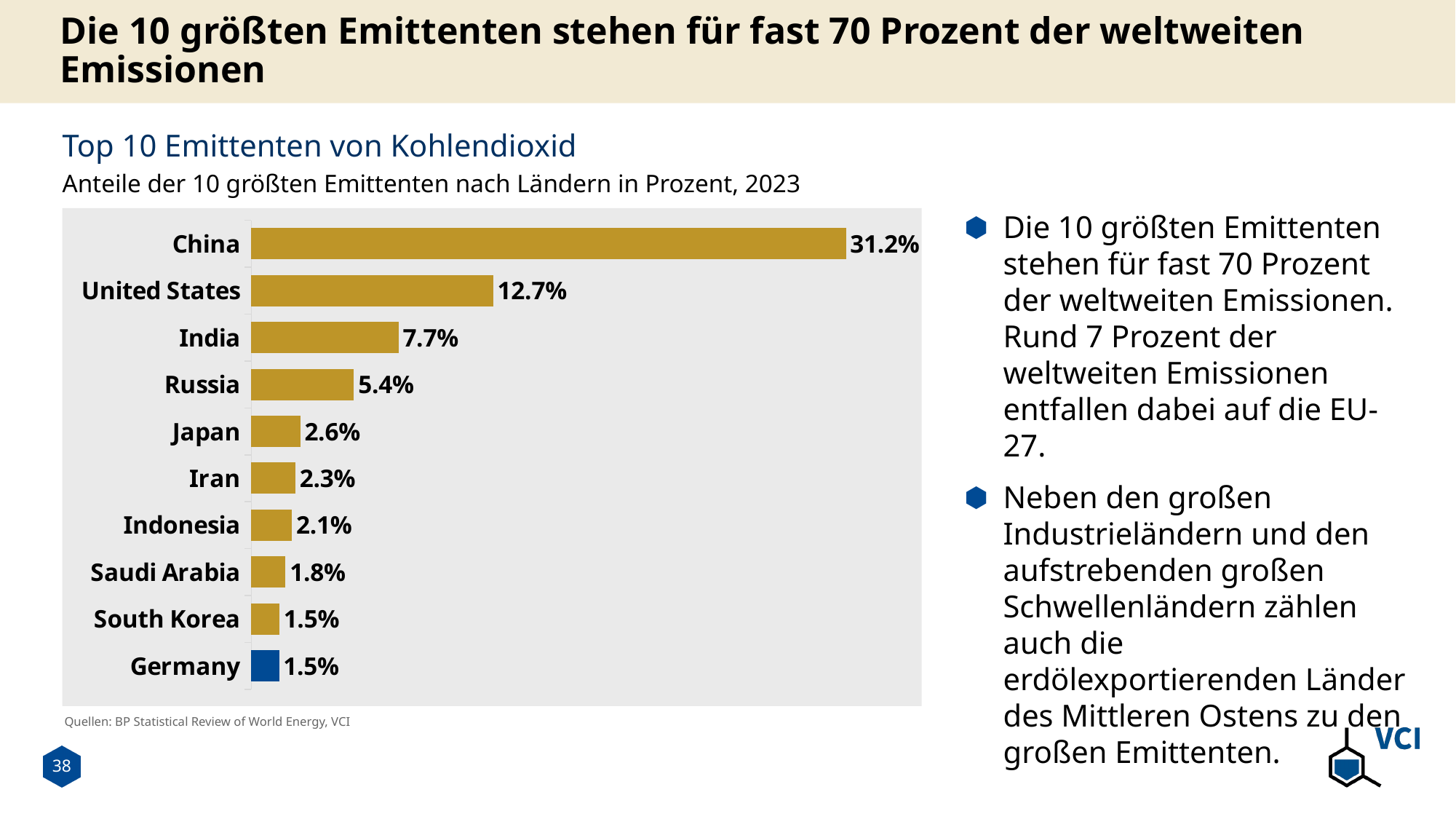
What is the value for China? 31.2% Do the values rise or fall from the top bar to the bottom bar? fall What is the difference between the values for Russia and Japan? 2.8% How many countries are shown in the chart? 10 Which country has the highest share? China Which country's bar is coloured blue instead of gold? Germany What is the value for Saudi Arabia? 1.8% Which is larger, the value for Iran or the value for Indonesia? Iran What is the difference between the values for China and the United States? 18.5% What is the title of the chart? Top 10 Emittenten von Kohlendioxid What kind of chart is this? bar chart What is the value for India? 7.7%